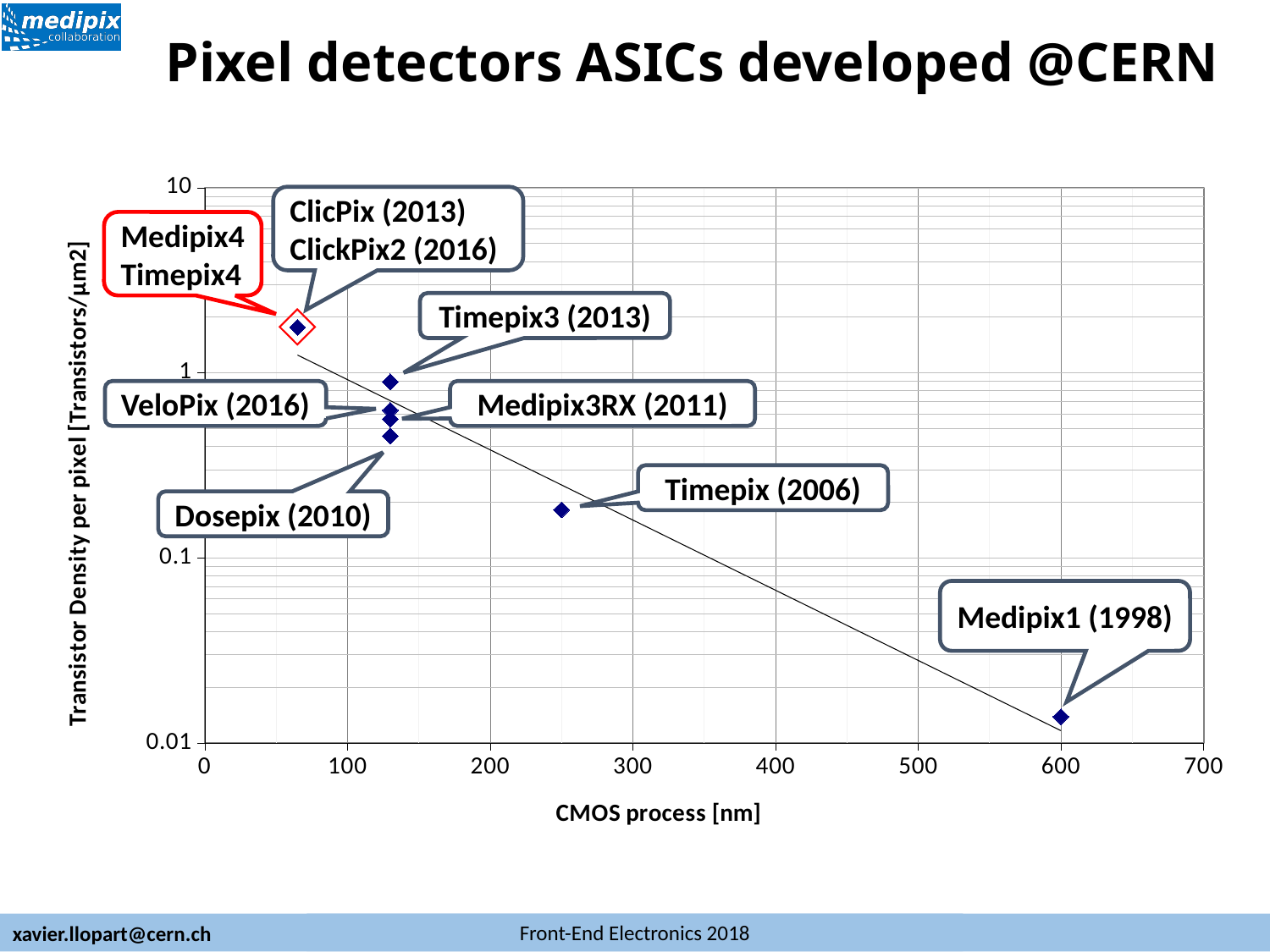
Which labelled detector has the lowest transistor density per pixel? Medipix1 (1998) What is the title of the chart on the slide? Pixel detectors ASICs developed @CERN What kind of chart is shown on the slide? Scatter chart What CMOS process value does the Medipix1 (1998) point sit at? 600 Is the transistor density per pixel for Timepix (2006) greater or less than 0.1? greater As the CMOS process value increases along the x axis, does the transistor density per pixel rise or fall? fall Is the transistor density per pixel for Medipix1 (1998) greater or less than 0.1? less Which has the higher transistor density per pixel, Timepix (2006) or Medipix1 (1998)? Timepix (2006) Which labelled detector uses the largest CMOS process node? Medipix1 (1998) Is the CMOS process value for Timepix (2006) greater or less than 200? greater What is the label of the x axis of the chart? CMOS process [nm]